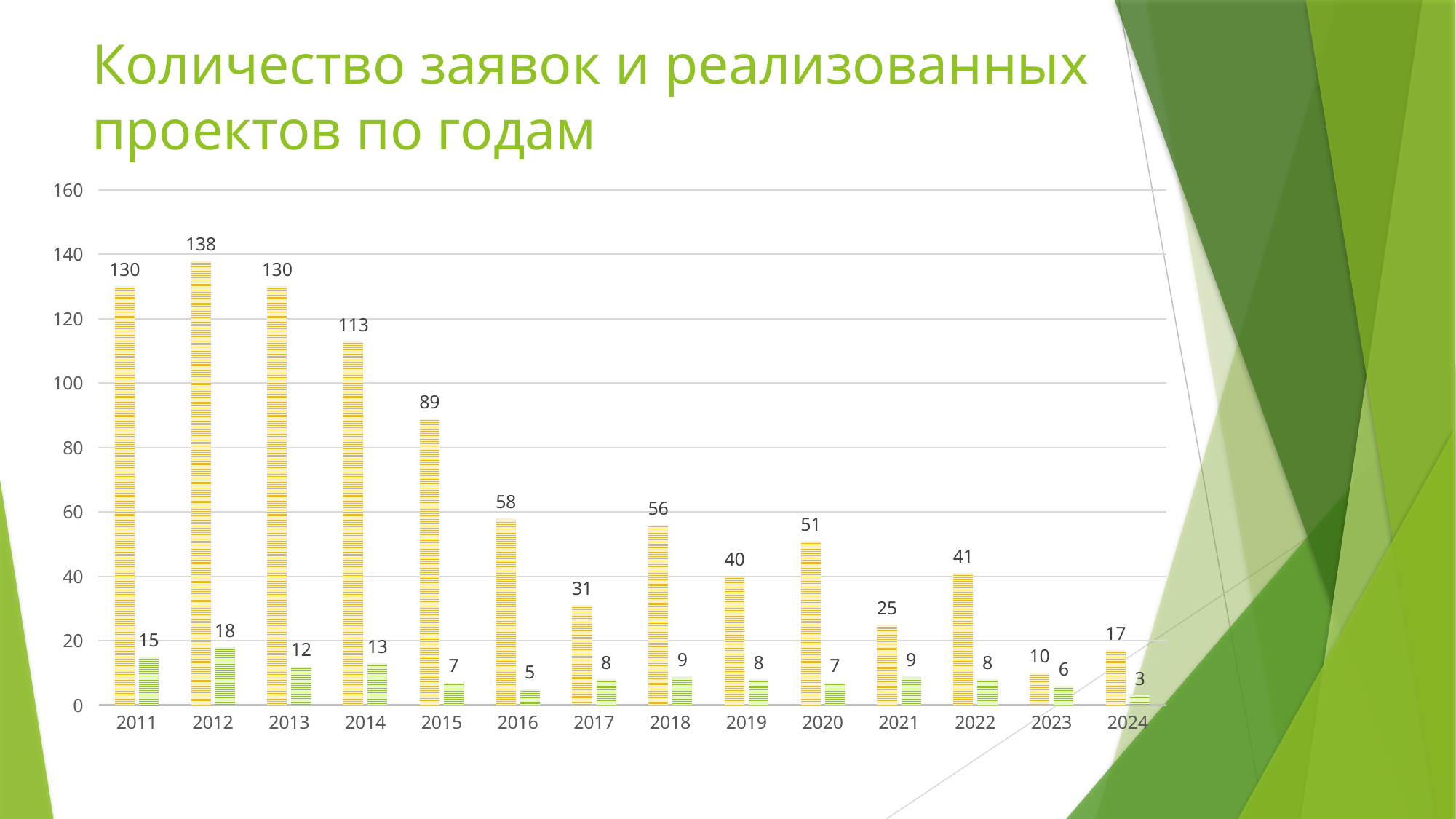
Which year has the lowest green bar? 2024 Do the orange bars generally rise or fall from 2011 to 2024? Fall What is the value of the orange bar for 2012? 138 What is the difference between the orange bar and the green bar for 2011? 115 Which is larger: the orange bar for 2018 or the orange bar for 2019? 2018 What is the difference between the orange bars for 2013 and 2014? 17 Which year has the highest orange bar? 2012 What kind of chart is shown on the slide? Bar chart What is the value of the orange bar for 2020? 51 How many years are shown on the x axis? 14 What is the title of the chart? Количество заявок и реализованных проектов по годам What is the value of the green bar for 2014? 13